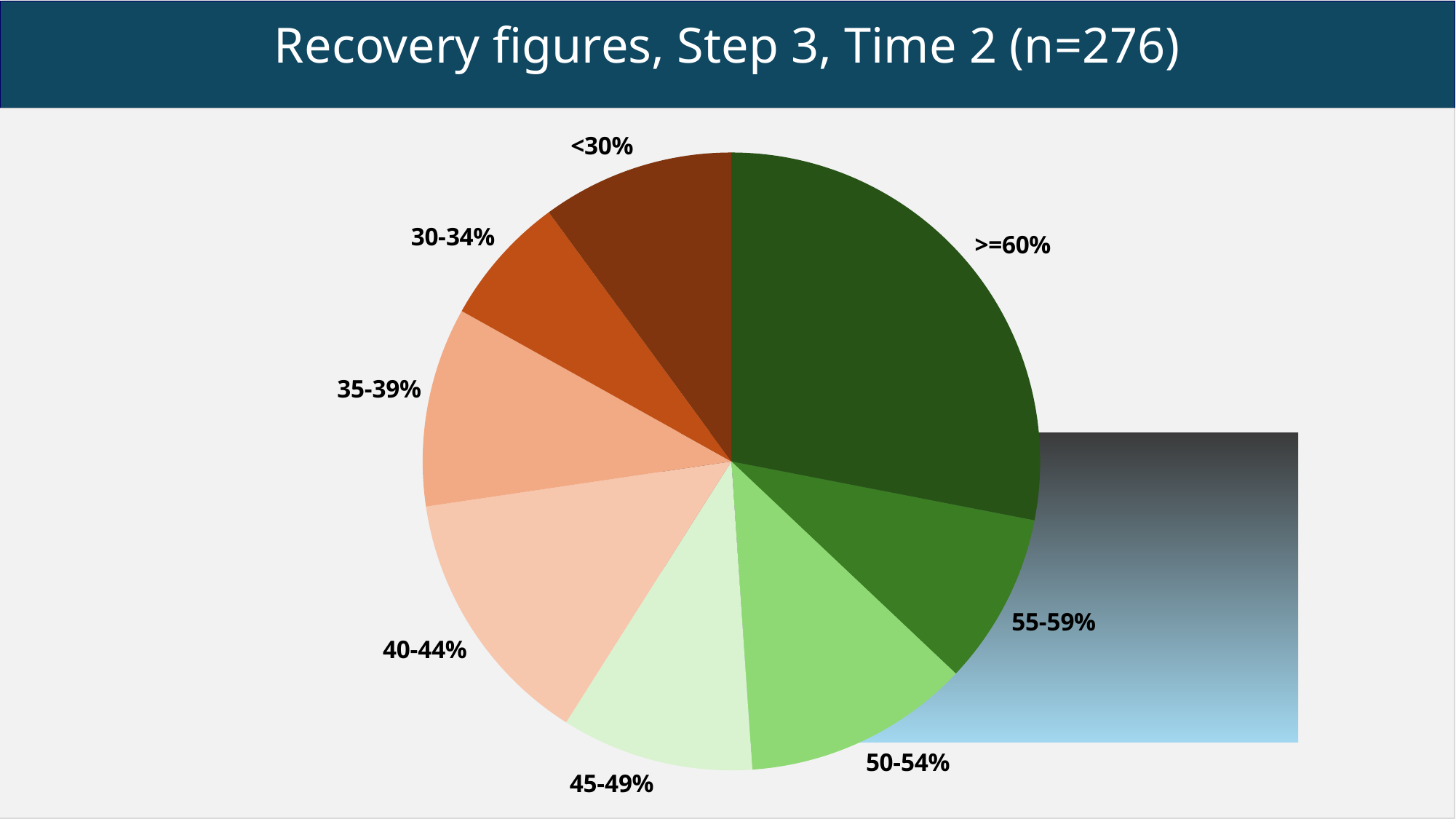
What kind of chart is shown on the slide? pie chart What is the sample size shown in the chart title? 276 Which slice is larger, 50-54% or 30-34%? 50-54% Which slice is larger, 40-44% or 30-34%? 40-44% Which category has the largest slice of the pie? >=60% Which slice is larger, >=60% or 55-59%? >=60% What is the title of the slide? Recovery figures, Step 3, Time 2 (n=276) How many slices does the pie chart have? 8